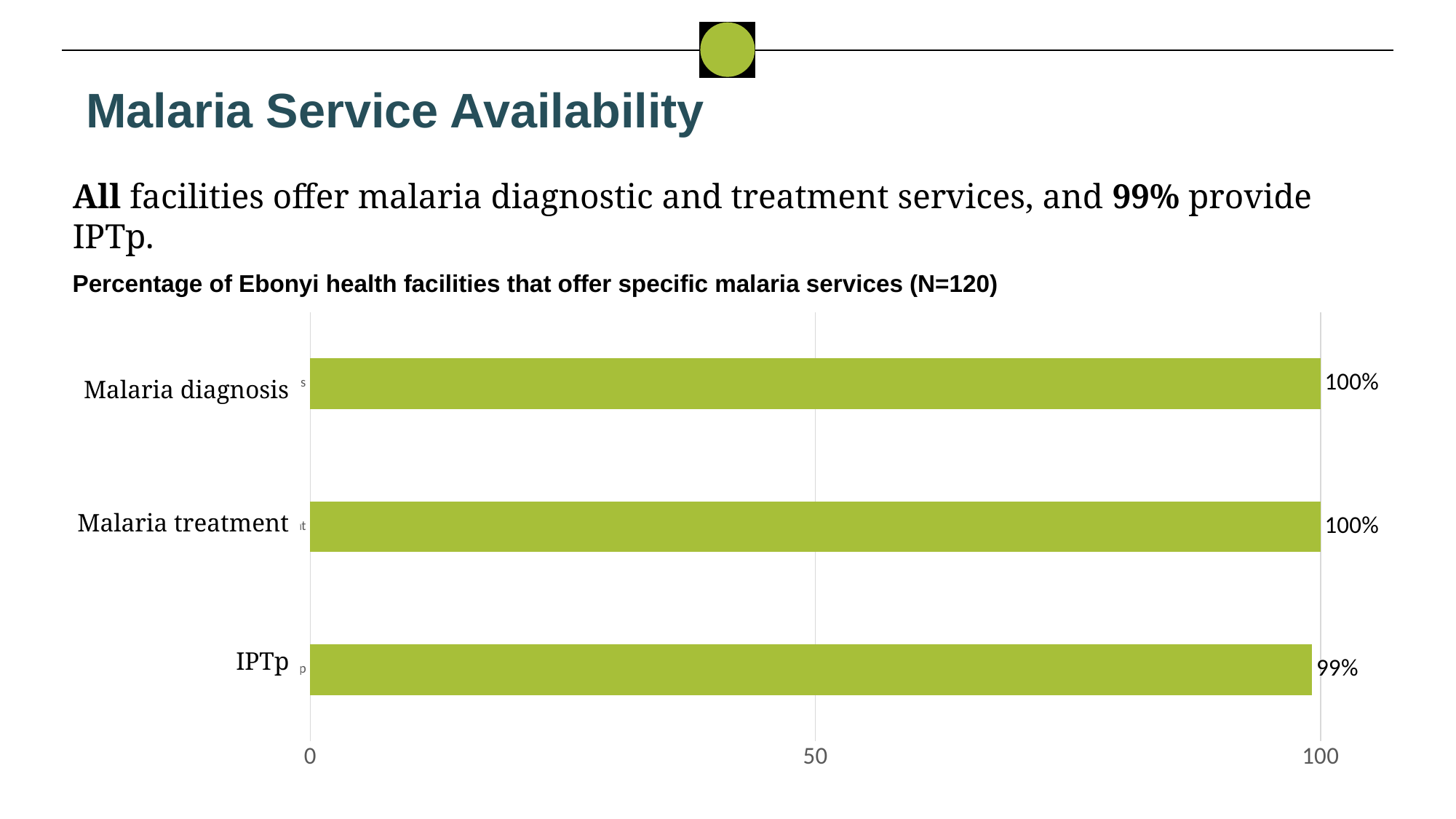
Is the value for IPTp greater or less than 50? greater What is the sample size (N) stated in the chart title? 120 What percentage of facilities provide IPTp? 99% What is the difference between the percentage for malaria diagnosis and the percentage for IPTp? 1% What percentage of facilities offer malaria treatment? 100% What percentage of facilities offer malaria diagnosis? 100% What kind of chart is shown on the slide? Bar chart Which is larger, the value for malaria treatment or the value for IPTp? Malaria treatment Which malaria service has the lowest percentage of facilities offering it? IPTp How many malaria services are shown in the chart? 3 What is the title of the chart? Percentage of Ebonyi health facilities that offer specific malaria services (N=120)